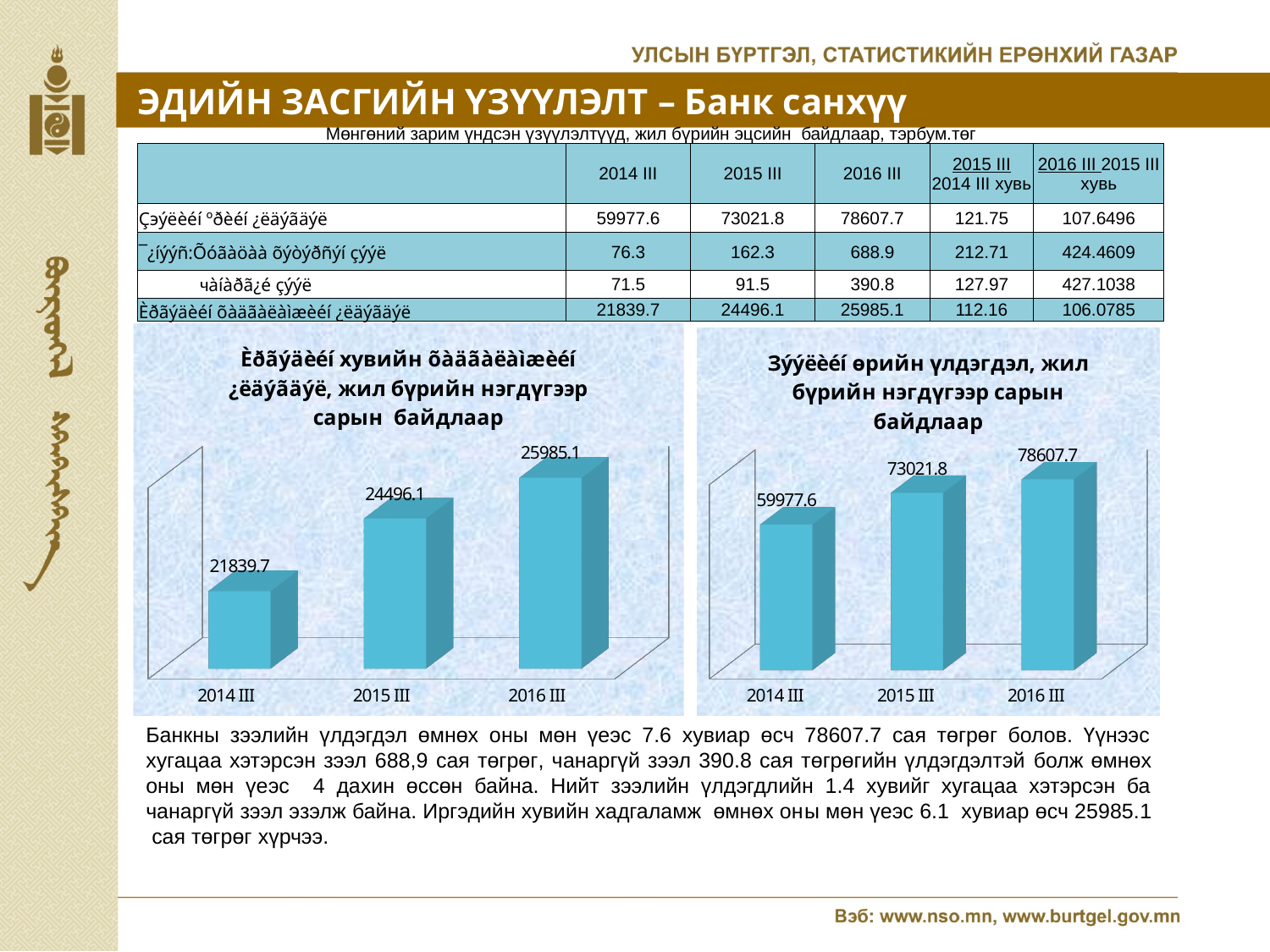
In the right chart, which category has the lowest value? 2014 III In the right chart, which is larger, the value for 2015 III or the value for 2014 III? 2015 III In the left chart, do the values rise or fall from 2014 III to 2016 III? rise How many categories are shown in the left chart? 3 In the left chart, what is the value for 2015 III? 24496.1 In the left chart, which category has the highest value? 2016 III In the right chart, what is the value for 2016 III? 78607.7 In the right chart, what is the difference between the values for 2016 III and 2015 III? 5585.9 In the left chart, what is the difference between the values for 2016 III and 2014 III? 4145.4 What colour are the bars in the right chart? blue What kind of chart is the right chart? bar chart In the right chart, what is the value for 2014 III? 59977.6